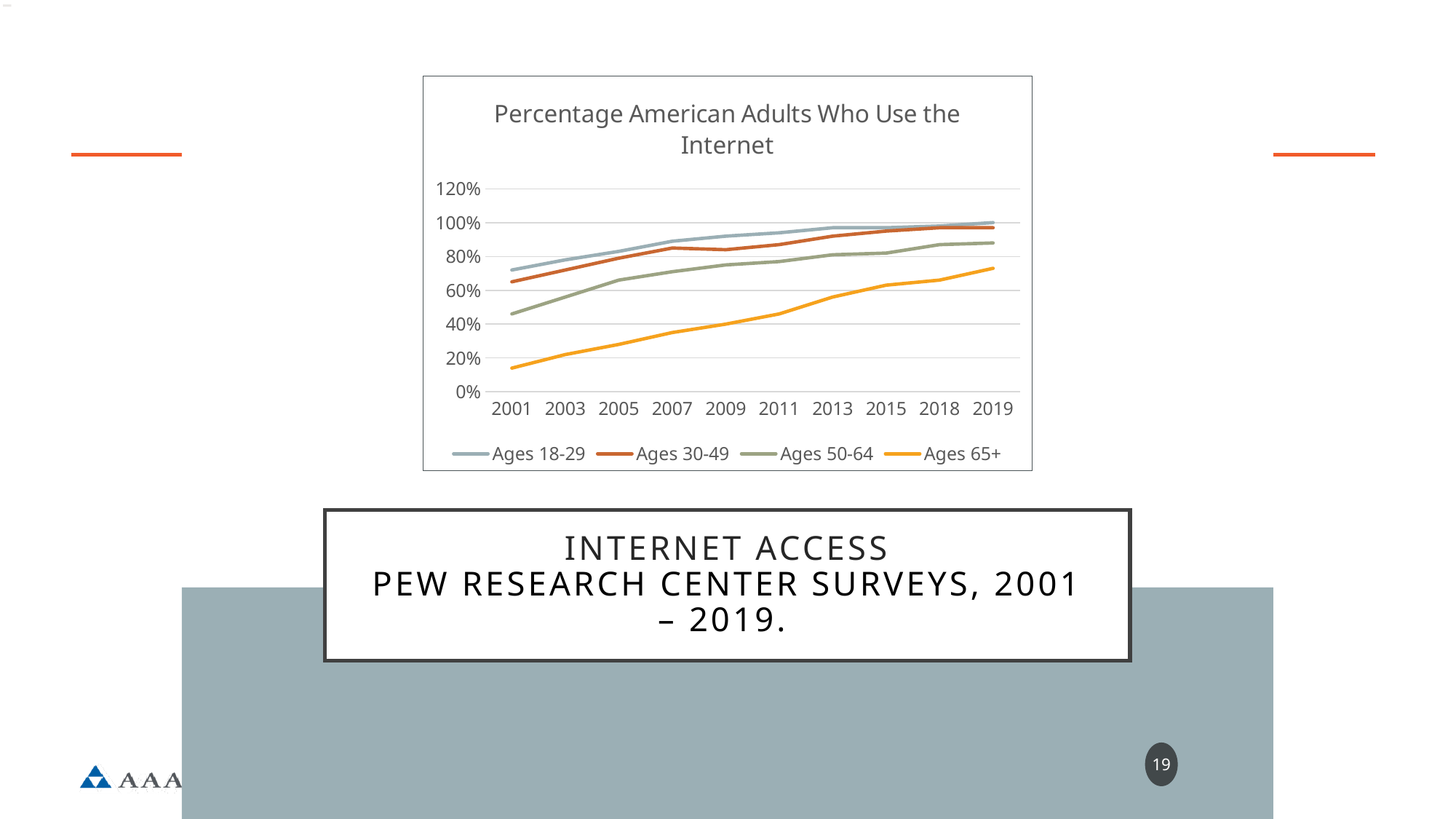
How many series does the legend list? 4 Does the Ages 65+ line rise or fall from 2001 to 2019? Rises Is the value for Ages 65+ in 2019 greater or less than 60%? greater Which age group has the highest internet use in 2001? Ages 18-29 Is the value for Ages 65+ in 2001 greater or less than 20%? less In 2009, which is larger: the value for Ages 30-49 or the value for Ages 65+? Ages 30-49 Is the value for Ages 50-64 in 2019 greater or less than 80%? greater How many years are shown along the x axis? 10 What is the title of the chart? Percentage American Adults Who Use the Internet Which age group has the lowest internet use in 2001? Ages 65+ What kind of chart is shown on the slide? Line chart